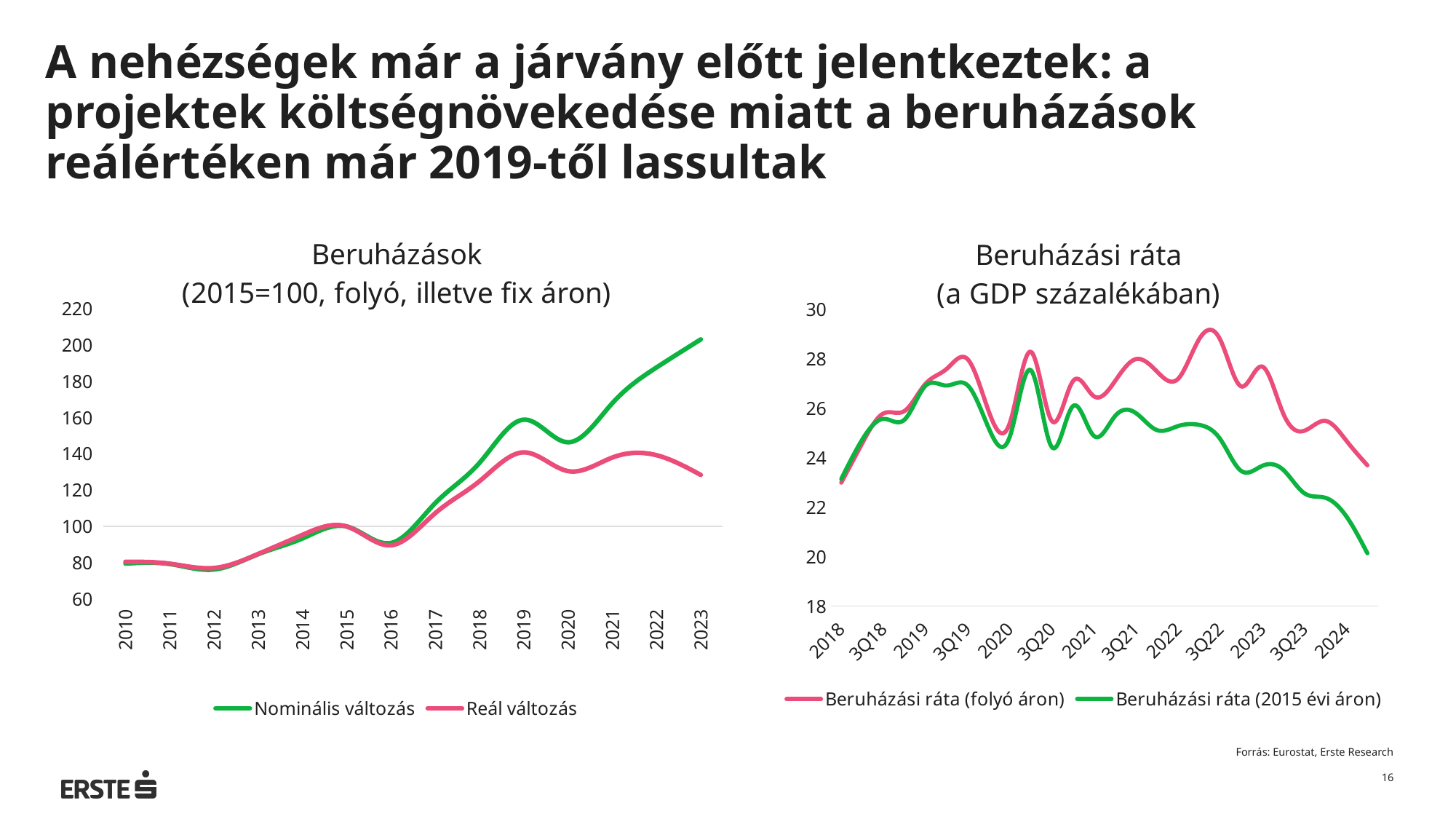
In the left chart "Beruházások", is the value of Nominális változás in 2023 greater or less than 200? greater What kind of chart is the right chart titled "Beruházási ráta"? line chart In the right chart "Beruházási ráta", is the value of Beruházási ráta (2015 évi áron) at the 2024 end of the series greater or less than 22? less In the left chart "Beruházások", does the Nominális változás line rise or fall between 2016 and 2023? rise In the right chart "Beruházási ráta", what colour is the line for Beruházási ráta (folyó áron)? pink What kind of chart is the left chart titled "Beruházások"? line chart In the right chart "Beruházási ráta", how many series does the legend list? 2 In the left chart "Beruházások", how many years are shown on the x axis? 14 In the left chart "Beruházások", is the value of Reál változás in 2023 greater or less than 140? less In the left chart "Beruházások", which series has the higher value in 2023, Nominális változás or Reál változás? Nominális változás In the right chart "Beruházási ráta", which series is higher at 2024, Beruházási ráta (folyó áron) or Beruházási ráta (2015 évi áron)? Beruházási ráta (folyó áron) In the left chart "Beruházások", how many series does the legend list? 2